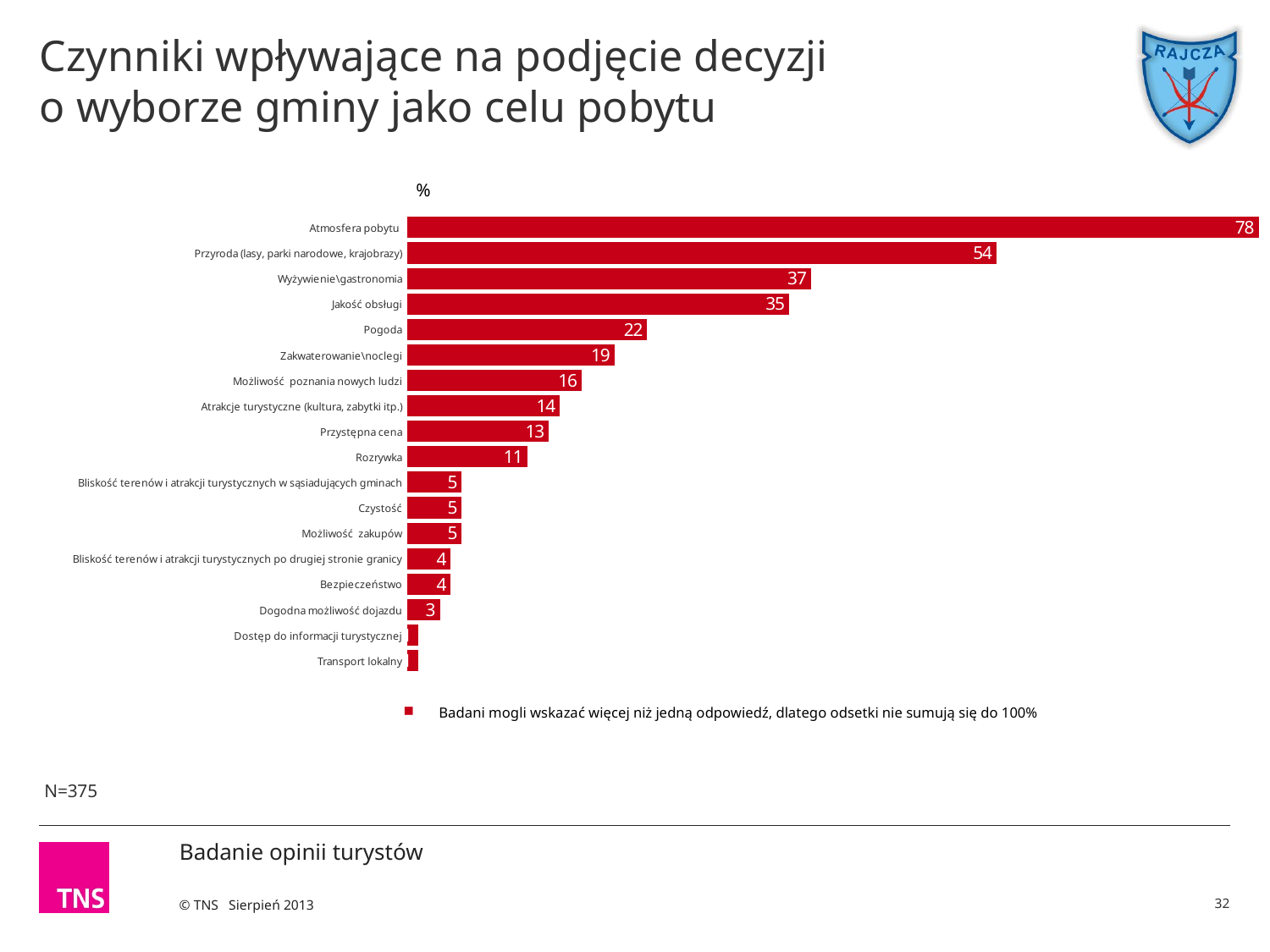
Which is larger, the value for Zakwaterowanie\noclegi or the value for Możliwość poznania nowych ludzi? Zakwaterowanie\noclegi What is the value for Przystępna cena? 13 What is the value for Atmosfera pobytu? 78 What kind of chart is shown on the slide? Bar chart Which is larger, the value for Rozrywka or the value for Dogodna możliwość dojazdu? Rozrywka What is the value for Przyroda (lasy, parki narodowe, krajobrazy)? 54 What is the difference between the values for Atmosfera pobytu and Przyroda (lasy, parki narodowe, krajobrazy)? 24 What unit is indicated above the chart? % What is the difference between the values for Wyżywienie\gastronomia and Jakość obsługi? 2 What is the value for Pogoda? 22 How many categories are shown in the chart? 18 Which category has the highest value? Atmosfera pobytu